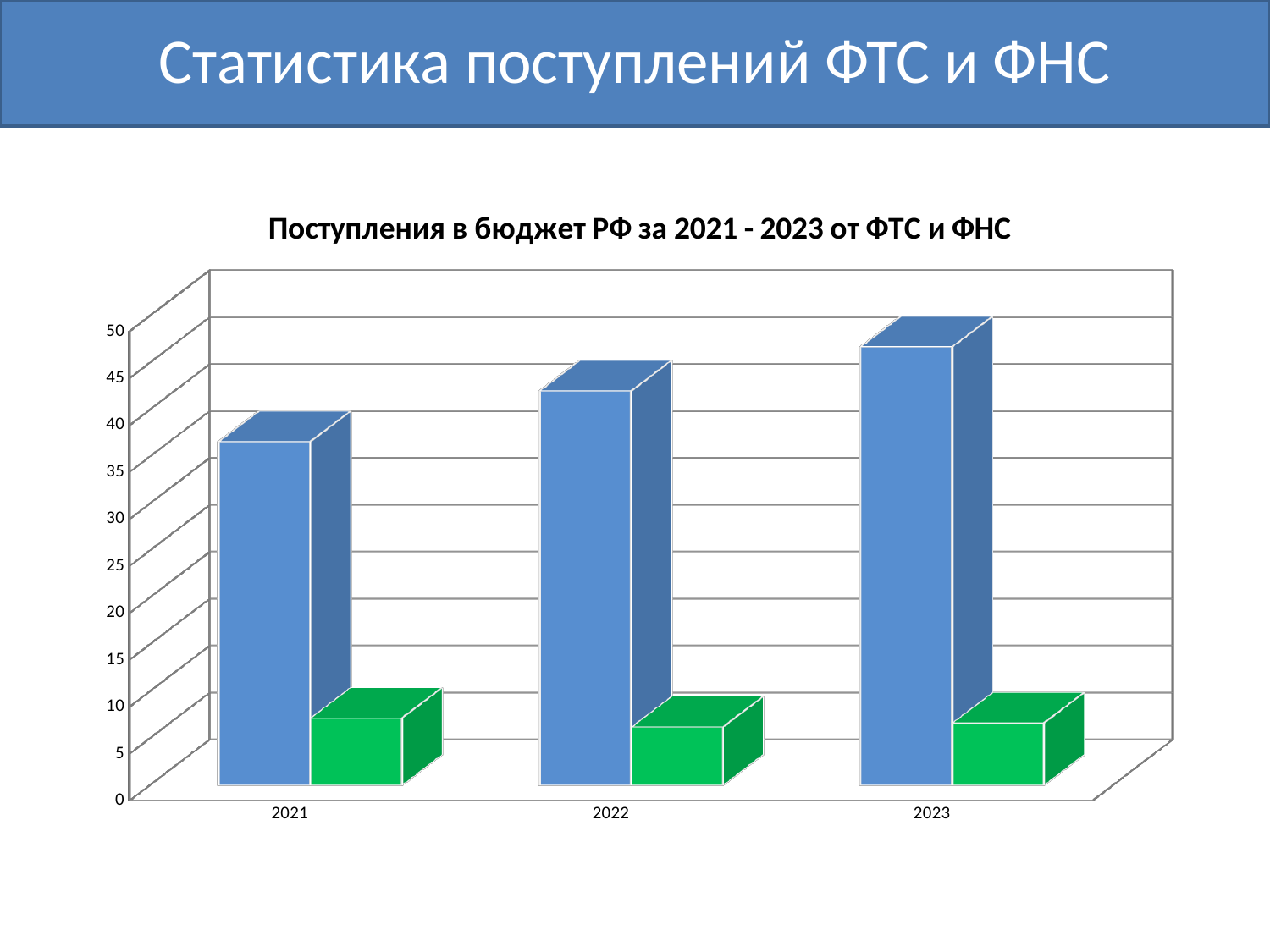
What is the title of the chart? Поступления в бюджет РФ за 2021 - 2023 от ФТС и ФНС In which year is the blue bar the lowest? 2021 How many years are shown on the x axis of the chart? 3 Is the value of the blue bar for 2021 greater or less than 30? greater Is the value of the blue bar for 2023 greater or less than 40? greater In 2022, which bar is larger, the blue one or the green one? the blue one Is the value of the blue bar for 2022 greater or less than 35? greater Do the blue bars rise or fall from 2021 to 2023? rise What colours are the two series of bars in the chart? blue and green What kind of chart is shown on the slide? bar chart In which year is the blue bar the highest? 2023